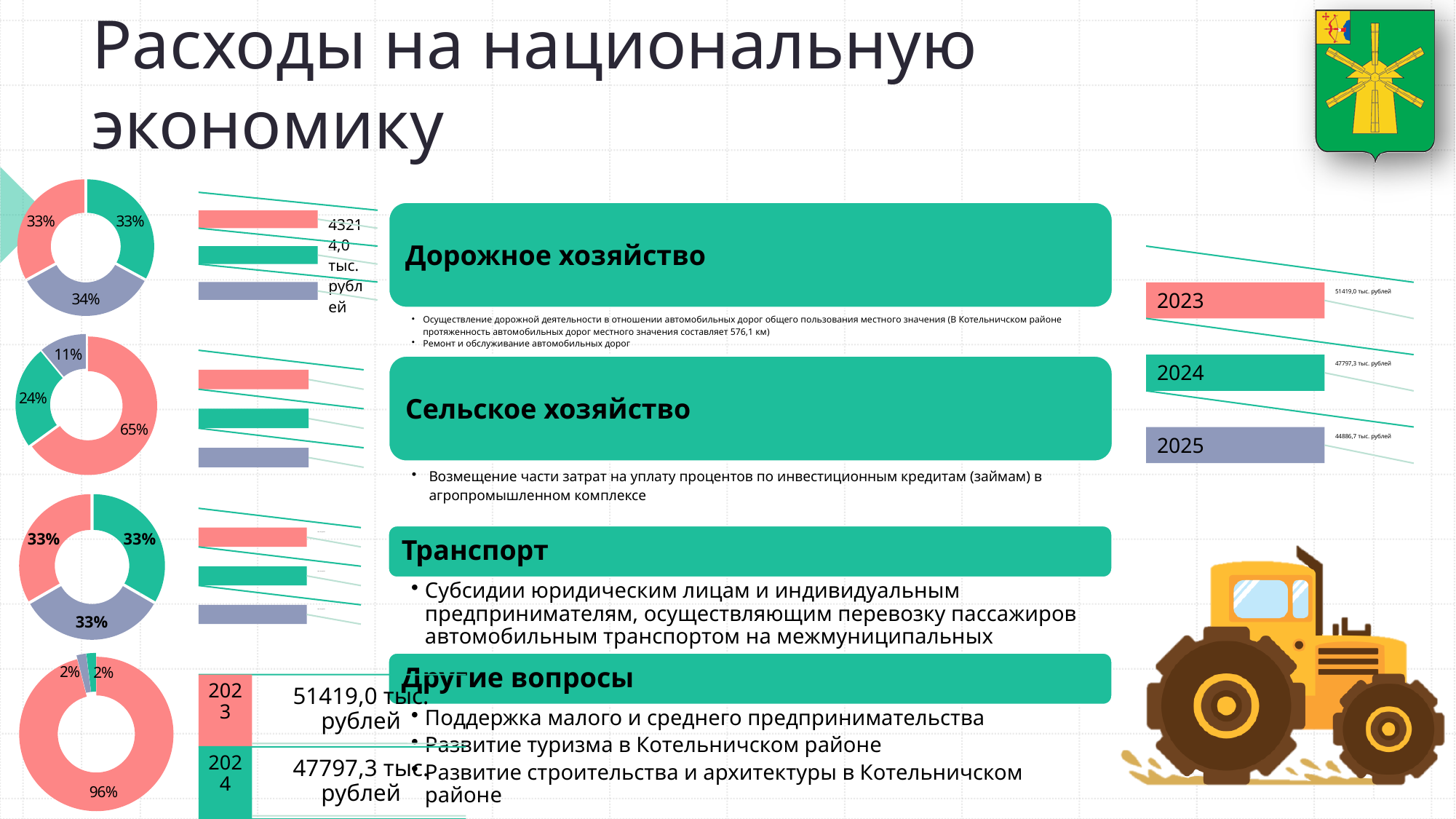
In the bar chart on the right side of the slide, do the values rise or fall from 2023 to 2025? fall In the bar chart at the bottom of the slide, what is the value for 2024? 47797,3 тыс. рублей In the bar chart on the right side of the slide, what is the difference between the 2023 and 2025 values? 6532,3 тыс. рублей In the bar chart on the right side of the slide, which year has the lowest value? 2025 In the second doughnut chart from the top on the left, what is the smallest slice's share? 11% In the bar chart on the right side of the slide, which year has the highest value? 2023 How many years (bars) are shown in the bar chart on the right side of the slide? 3 In the bottom doughnut chart on the left, what is the share of the largest slice? 96% In the bar chart on the right side of the slide, what is the value for 2025? 44886,7 тыс. рублей In the bar chart on the right side of the slide, what is the value for 2023? 51419,0 тыс. рублей In the second doughnut chart from the top on the left, what is the largest slice's share? 65% What kind of chart is the chart on the right side of the slide with the years 2023, 2024 and 2025? bar chart